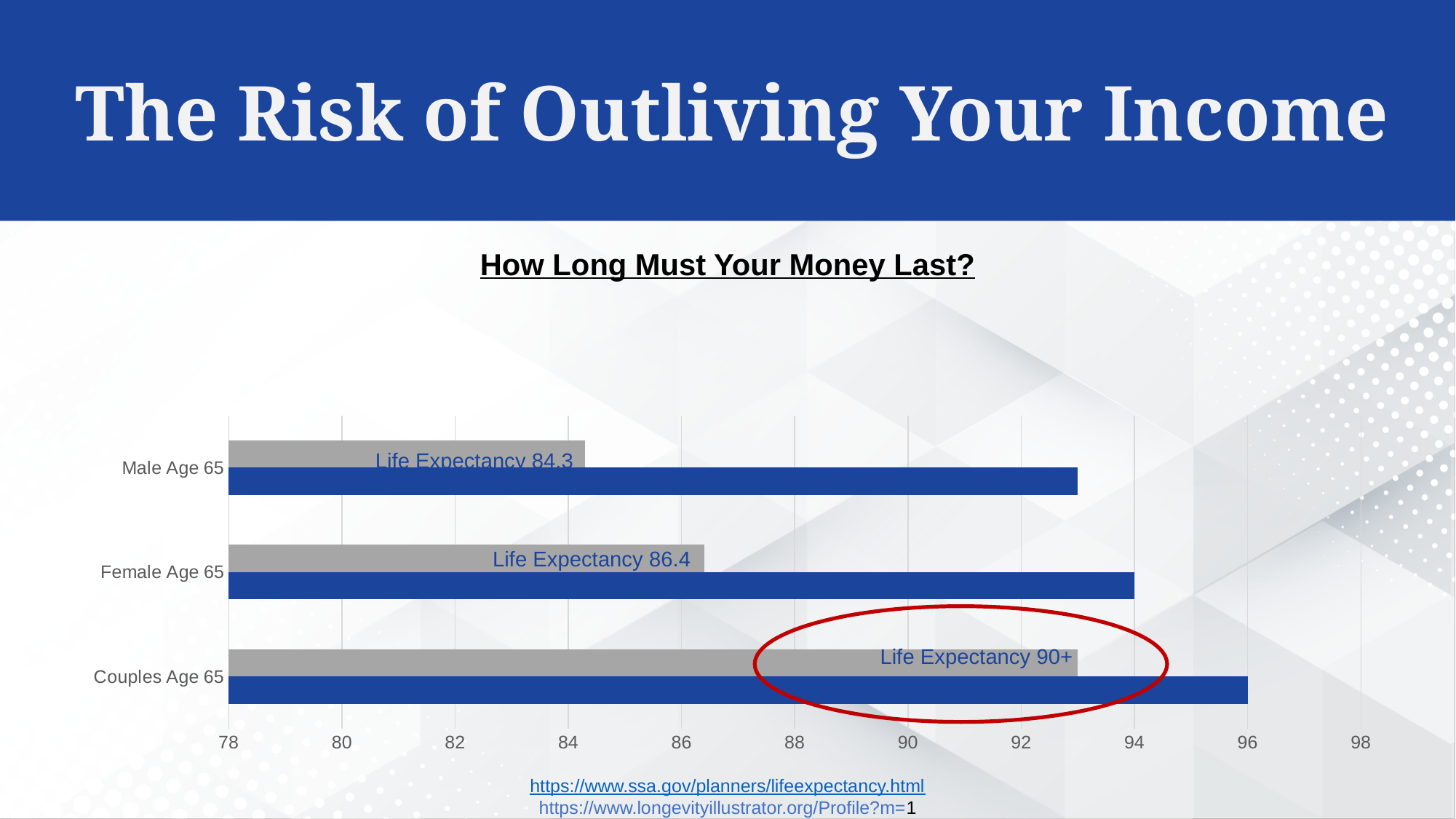
Is the value of the blue bar for Male Age 65 greater or less than 94? less Which has the higher labelled life expectancy, Male Age 65 or Female Age 65? Female Age 65 What is the life expectancy value labelled for Male Age 65? 84.3 Which category has the longest blue bar? Couples Age 65 What is the title shown above the chart? How Long Must Your Money Last? What kind of chart is shown on the slide? bar chart What is the life expectancy value labelled for Couples Age 65? 90+ What is the difference between the labelled life expectancy for Female Age 65 and Male Age 65? 2.1 Is the value of the blue bar for Couples Age 65 greater or less than 94? greater How many categories are shown on the chart? 3 What is the life expectancy value labelled for Female Age 65? 86.4 What is the lowest value shown on the horizontal axis? 78